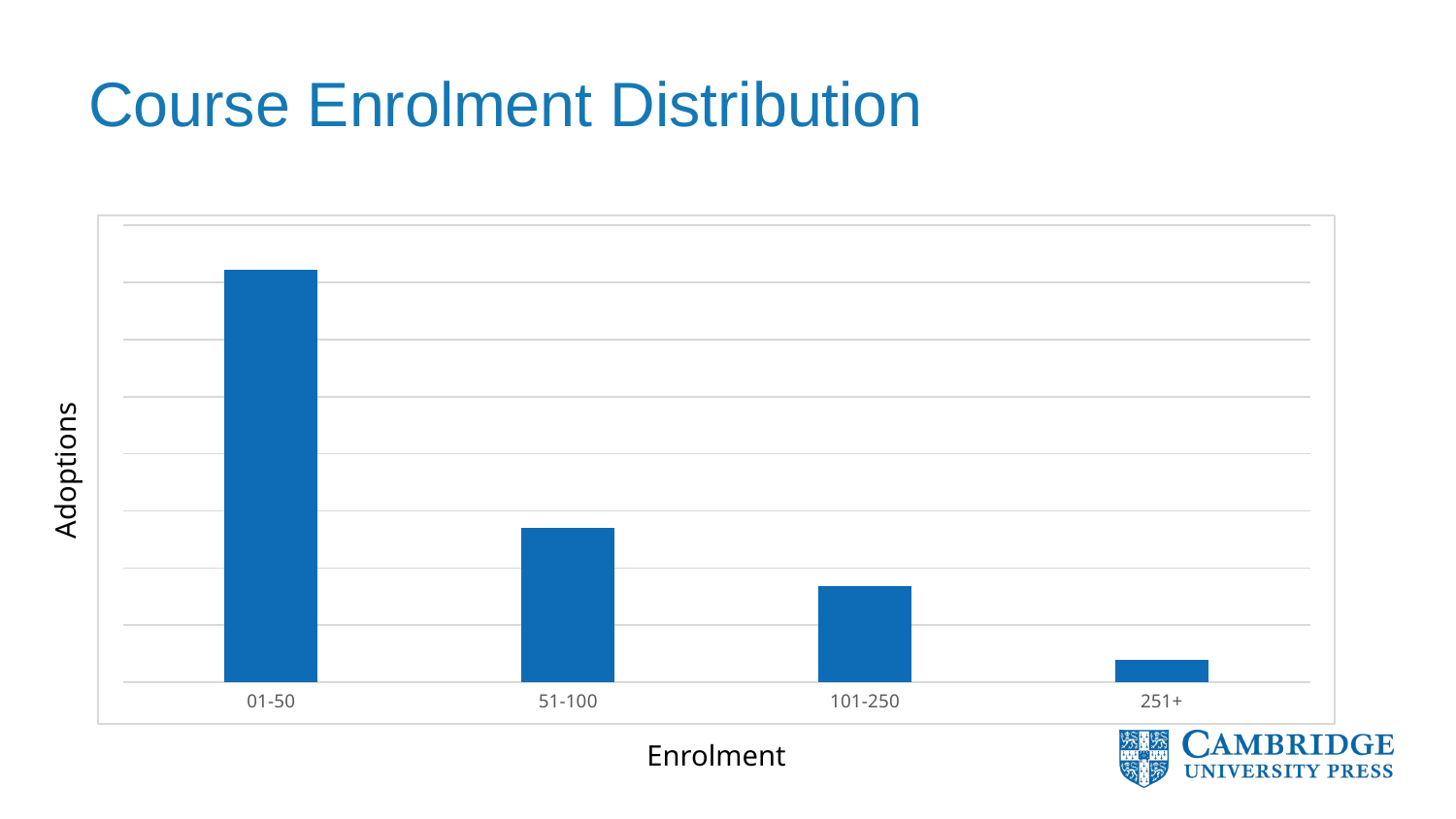
How many enrolment categories are shown on the x axis? 4 Which has more adoptions, the 01-50 category or the 51-100 category? 01-50 Which has more adoptions, the 51-100 category or the 101-250 category? 51-100 Which enrolment category has the lowest number of adoptions? 251+ What kind of chart is shown on the slide? bar chart Which has more adoptions, the 101-250 category or the 251+ category? 101-250 Do adoptions rise or fall as enrolment size increases along the x axis? fall What is the title of the chart? Course Enrolment Distribution Which enrolment category has the highest number of adoptions? 01-50 What is the label on the y axis? Adoptions